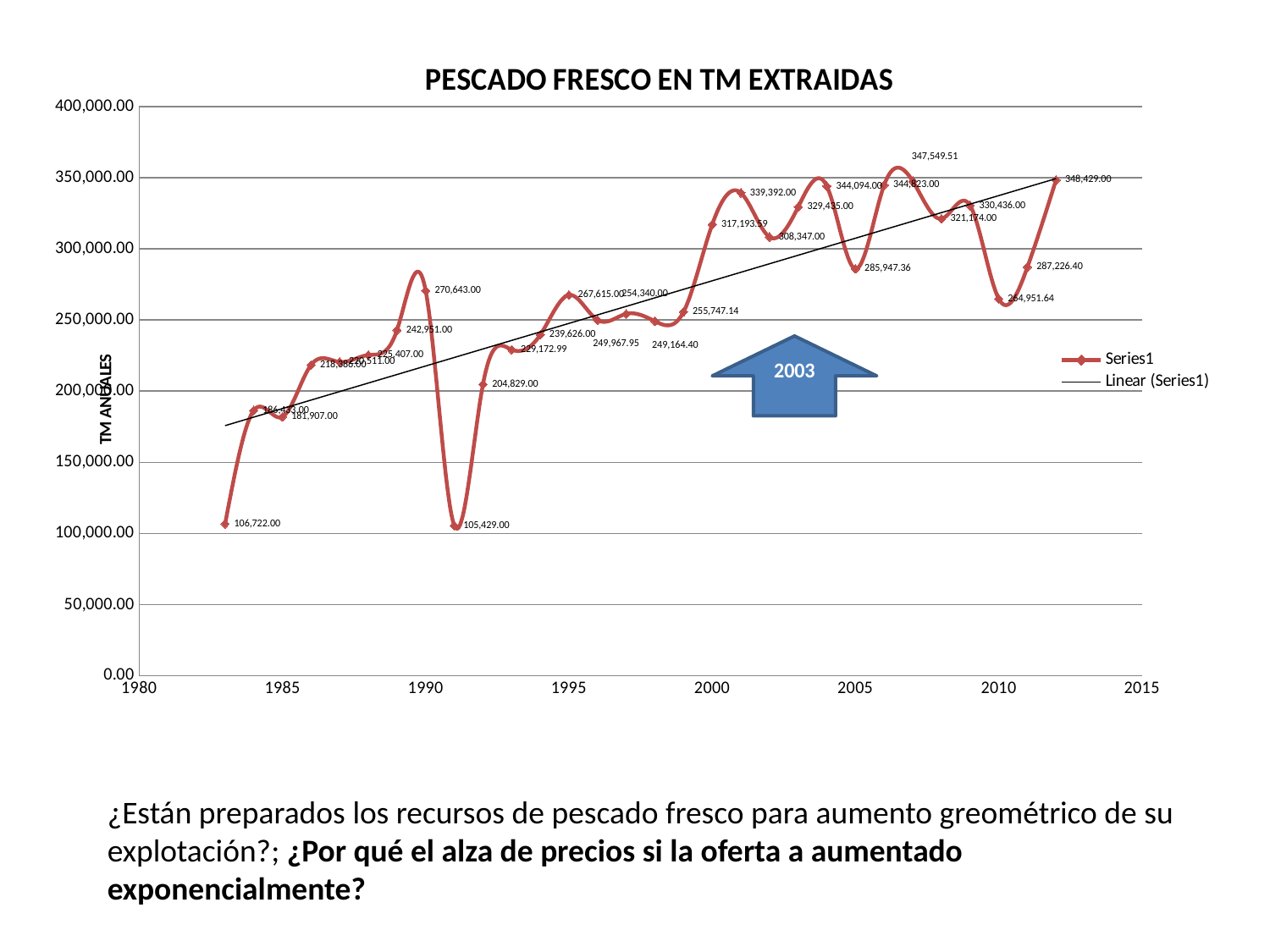
What is the value plotted for the year 2005? 285,947.36 Overall, do the values rise or fall from 1983 to 2012? rise What is the value plotted for the year 2000? 317,193.59 How many entries does the chart legend list? 2 What is the lowest labeled value on the chart? 105,429.00 What is the value plotted for the year 2010? 264,951.64 What is the value plotted for the year 1995? 267,615.00 Is the value for 1990 greater or less than 250,000.00? greater What type of chart is shown on the slide? line chart What is the difference between the values for 2000 and 1995? 49,578.59 What is the title of the chart? PESCADO FRESCO EN TM EXTRAIDAS What is the highest labeled value on the chart? 348,429.00